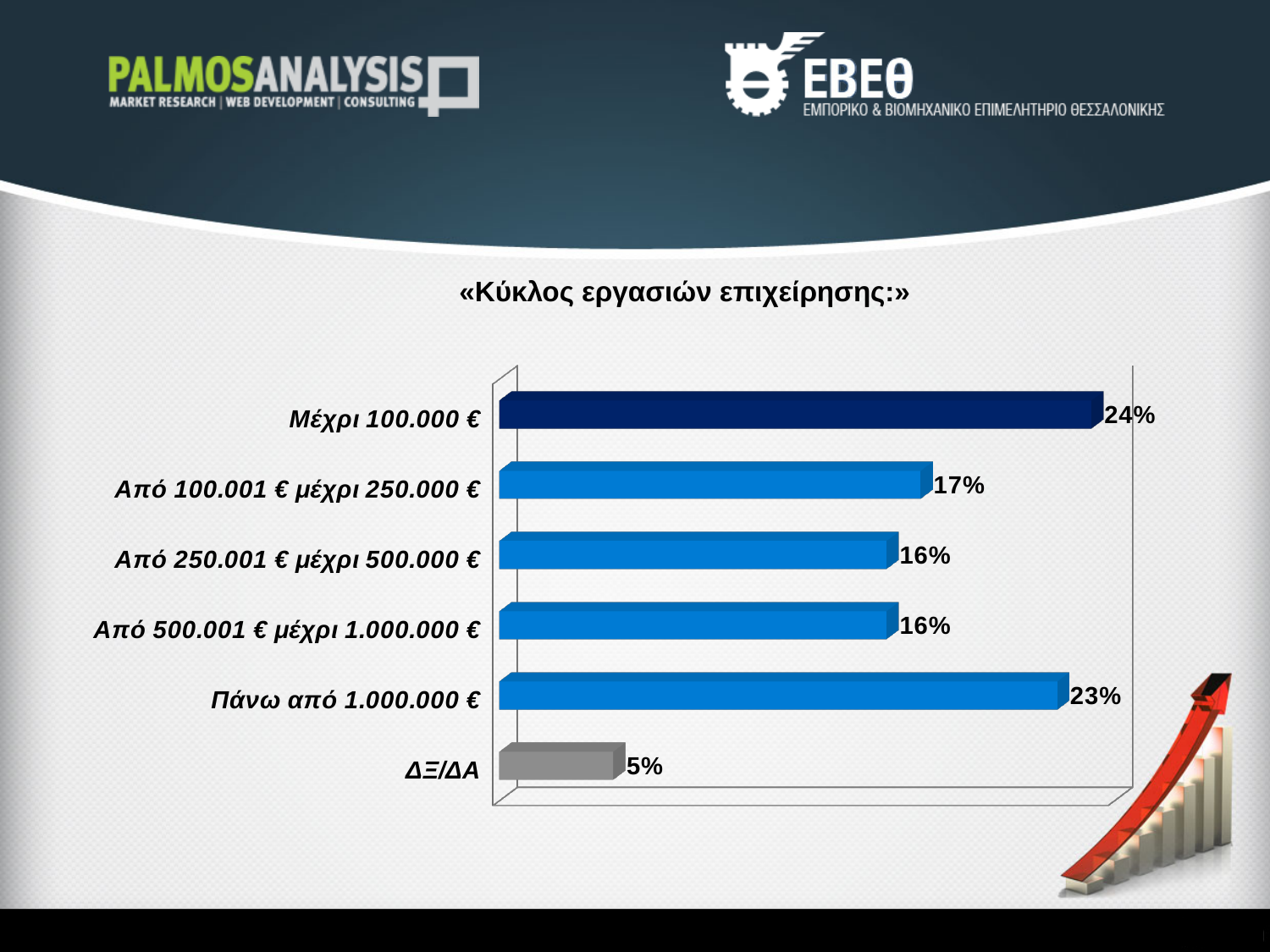
What kind of chart is shown on the slide? Bar chart What is the value for «Πάνω από 1.000.000 €»? 23% Which category has the highest value? Μέχρι 100.000 € What is the value for «Από 100.001 € μέχρι 250.000 €»? 17% How many categories are shown in the chart? 6 What is the difference between the values for «Μέχρι 100.000 €» and «Πάνω από 1.000.000 €»? 1% What is the value for «Μέχρι 100.000 €»? 24% Which category has the lowest value? ΔΞ/ΔΑ What is the difference between the values for «Από 100.001 € μέχρι 250.000 €» and «ΔΞ/ΔΑ»? 12% Which is larger: the value for «Από 100.001 € μέχρι 250.000 €» or the value for «Από 250.001 € μέχρι 500.000 €»? Από 100.001 € μέχρι 250.000 € What is the value for «ΔΞ/ΔΑ»? 5% What is the title of the chart? «Κύκλος εργασιών επιχείρησης:»